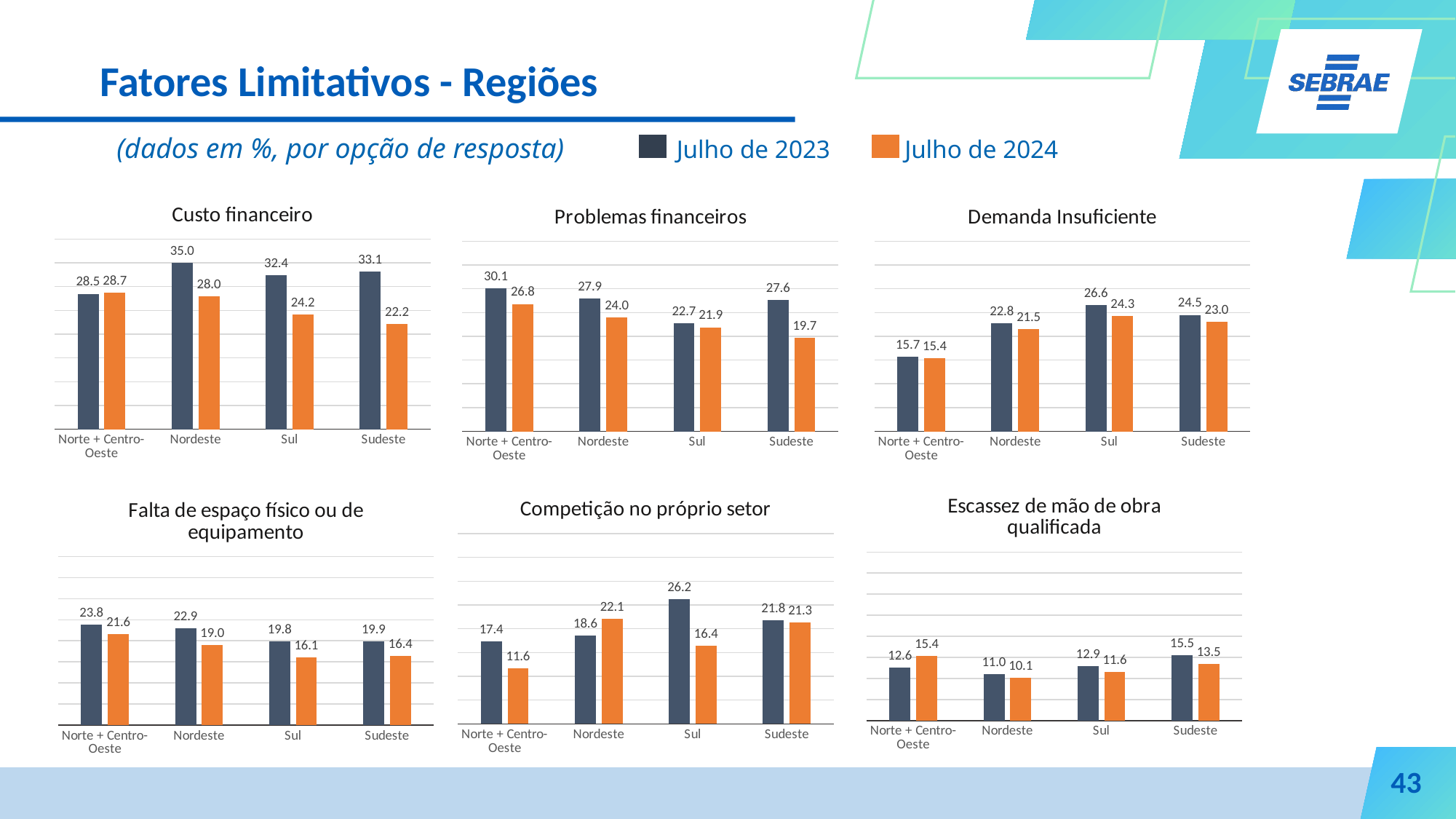
In the 'Custo financeiro' chart, what is the difference between the Julho de 2023 and Julho de 2024 values for Sudeste? 10.9 What kind of chart is 'Demanda Insuficiente'? Bar chart How many regions are shown on the x axis of the 'Problemas financeiros' chart? 4 In the 'Demanda Insuficiente' chart, which region has the lowest value in Julho de 2023? Norte + Centro-Oeste In the 'Competição no próprio setor' chart, which region has the highest value in Julho de 2023? Sul How many series does the legend list? 2 Which colour represents Julho de 2024 in the charts? Orange In the 'Competição no próprio setor' chart, what is the difference between the Julho de 2023 and Julho de 2024 values for Sul? 9.8 In the 'Problemas financeiros' chart, what is the value for Sudeste in Julho de 2024? 19.7 In the 'Falta de espaço físico ou de equipamento' chart, what is the value for Sul in Julho de 2024? 16.1 In the 'Custo financeiro' chart, what is the value for Nordeste in Julho de 2023? 35.0 In the 'Escassez de mão de obra qualificada' chart, which is larger for Norte + Centro-Oeste: Julho de 2023 or Julho de 2024? Julho de 2024